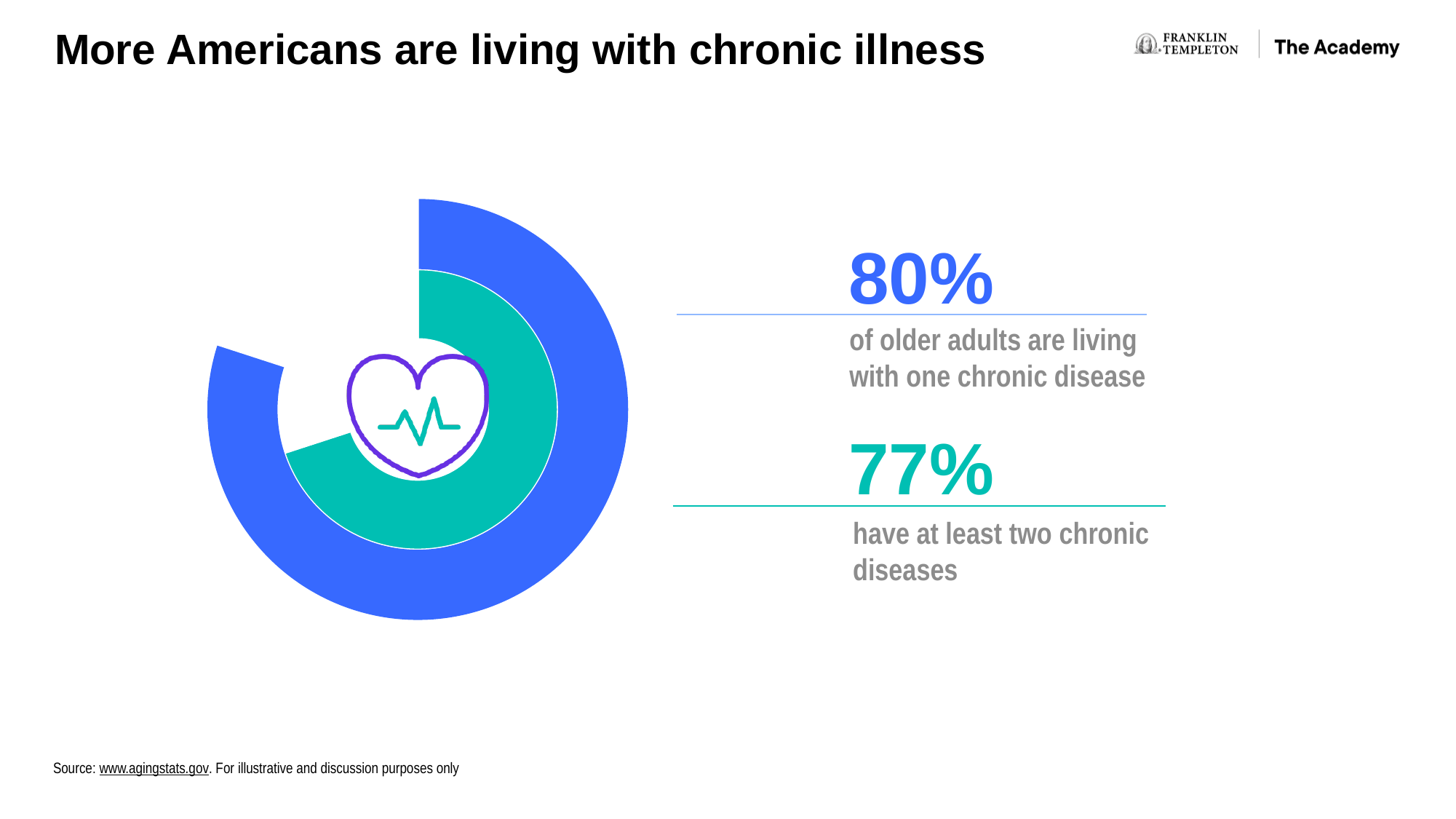
What is the title of the slide containing the chart? More Americans are living with chronic illness What percentage of older adults have at least two chronic diseases? 77% Is the value for at least two chronic diseases larger or smaller than the value for one chronic disease? Smaller What percentage of older adults are living with one chronic disease? 80% What is the difference in percentage points between the share with one chronic disease and the share with at least two chronic diseases? 3 percentage points How many percentage values are plotted in the chart? 2 What kind of chart is used to display the two percentages? Doughnut chart Which of the two percentages shown is the lowest? 77% (at least two chronic diseases) What colour is the arc representing the 80% value? Blue Which statistic is higher: older adults living with one chronic disease or those with at least two chronic diseases? One chronic disease (80%)